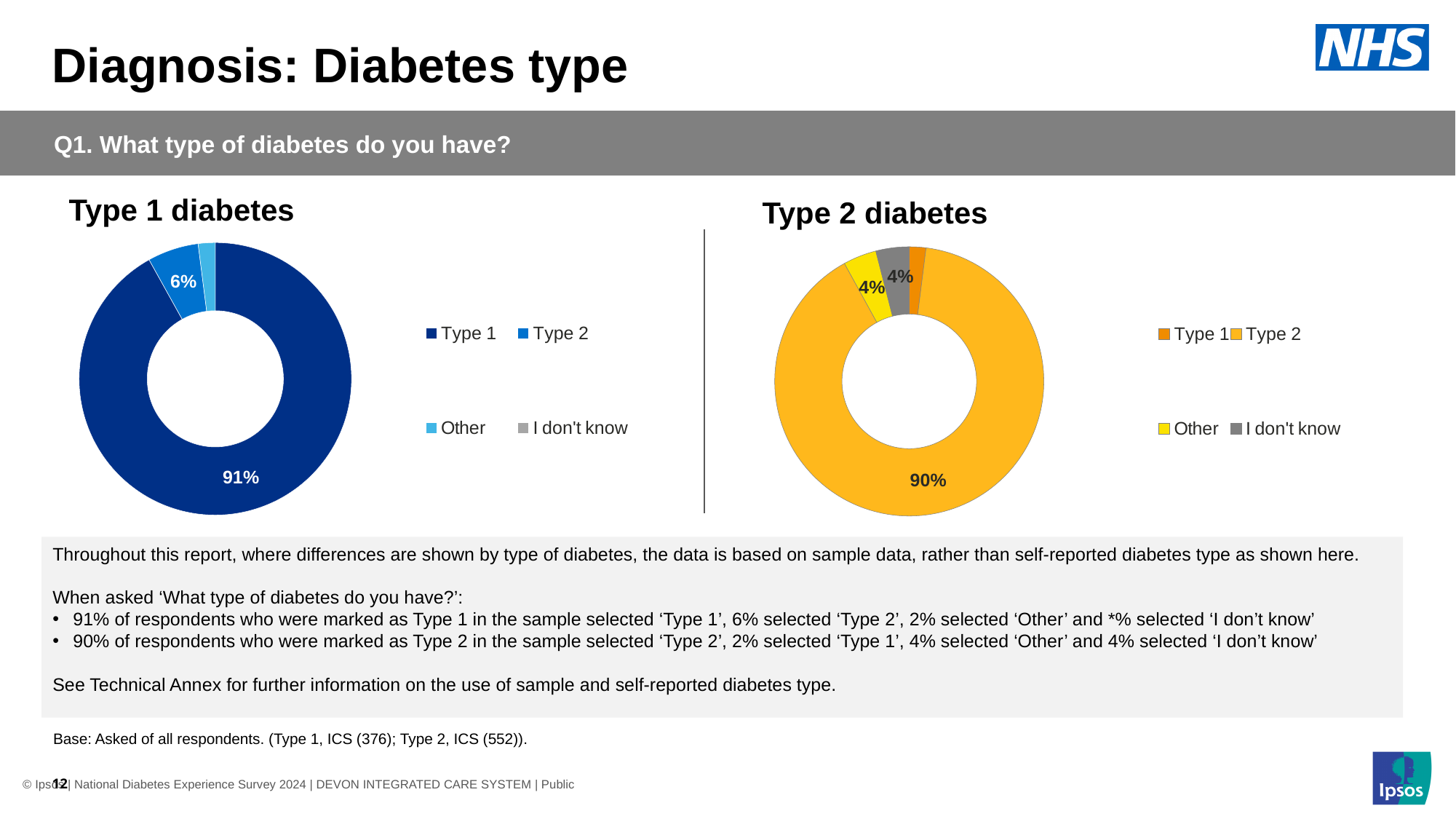
In the Type 1 diabetes chart, which category has the largest share? Type 1 In the Type 2 diabetes chart, what percentage of respondents selected 'I don't know'? 4% In the Type 2 diabetes chart, which category has the largest share? Type 2 What kind of chart is used for the Type 1 diabetes and Type 2 diabetes data? Pie (donut) chart In the Type 1 diabetes chart, what percentage of respondents selected 'Type 2'? 6% In the Type 2 diabetes chart, what percentage of respondents selected 'Other'? 4% In the Type 2 diabetes chart, what percentage of respondents selected 'Type 2'? 90% In the Type 1 diabetes chart, what is the difference in percentage points between the 'Type 1' and 'Type 2' shares? 85 percentage points In the Type 1 diabetes chart, what percentage of respondents selected 'Type 1'? 91% How many categories does the legend of the Type 2 diabetes chart list? 4 In the Type 2 diabetes chart, which category has the smallest share? Type 1 In the Type 1 diabetes chart, which is larger: the 'Type 1' share or the 'Type 2' share? Type 1